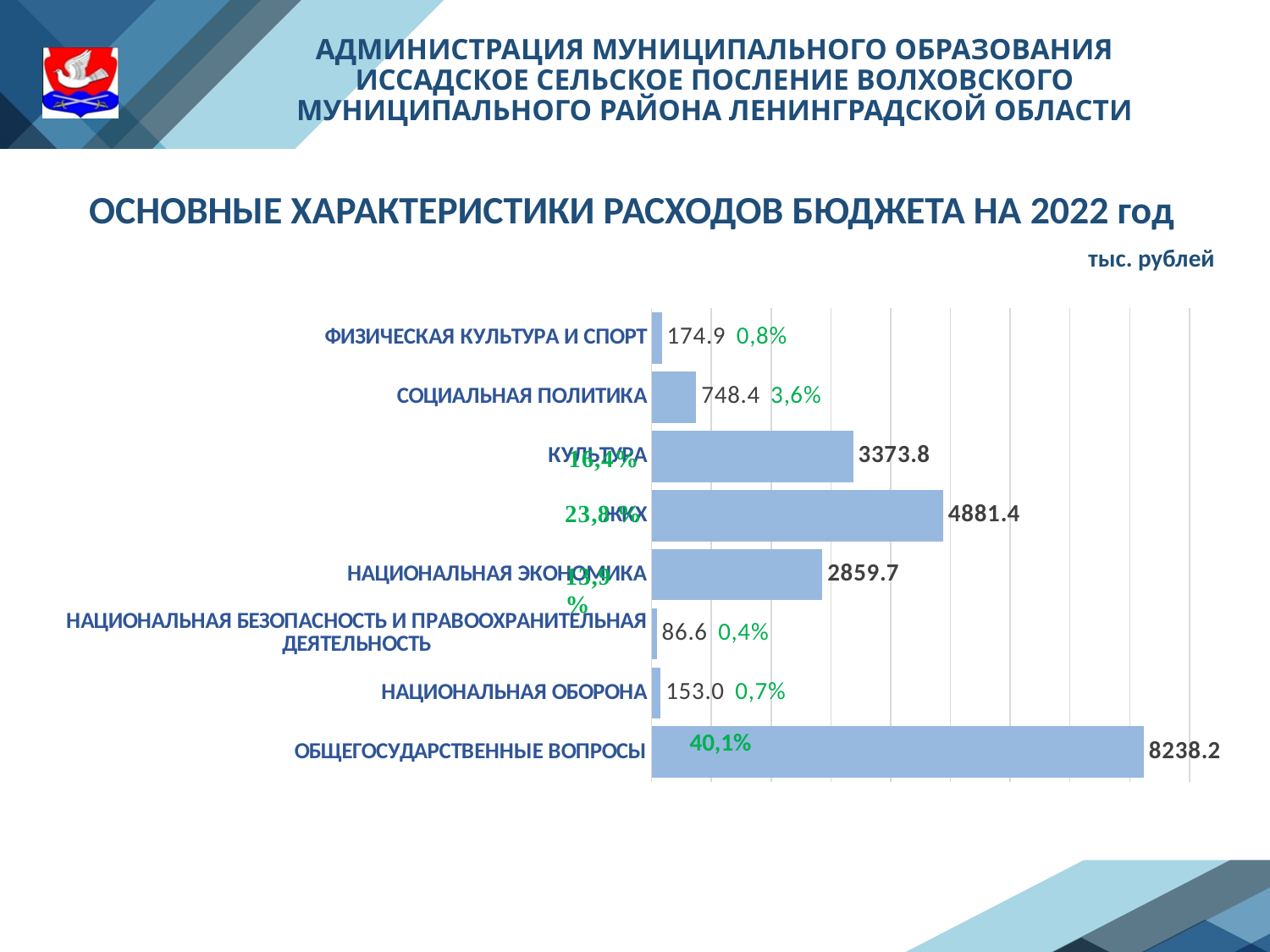
Which category has the highest value? ОБЩЕГОСУДАРСТВЕННЫЕ ВОПРОСЫ What type of chart is shown on the slide? bar chart What is the value for НАЦИОНАЛЬНАЯ ЭКОНОМИКА? 2859.7 What percentage share is shown for ОБЩЕГОСУДАРСТВЕННЫЕ ВОПРОСЫ? 40,1% What is the difference between the values for ЖКХ and КУЛЬТУРА? 1507.6 What is the value for ОБЩЕГОСУДАРСТВЕННЫЕ ВОПРОСЫ? 8238.2 What is the value for СОЦИАЛЬНАЯ ПОЛИТИКА? 748.4 Which is larger, the value for КУЛЬТУРА or for НАЦИОНАЛЬНАЯ ЭКОНОМИКА? КУЛЬТУРА What is the value for ЖКХ? 4881.4 In what units are the chart values given, according to the slide? тыс. рублей How many categories are shown in the chart? 8 Which category has the lowest value? НАЦИОНАЛЬНАЯ БЕЗОПАСНОСТЬ И ПРАВООХРАНИТЕЛЬНАЯ ДЕЯТЕЛЬНОСТЬ